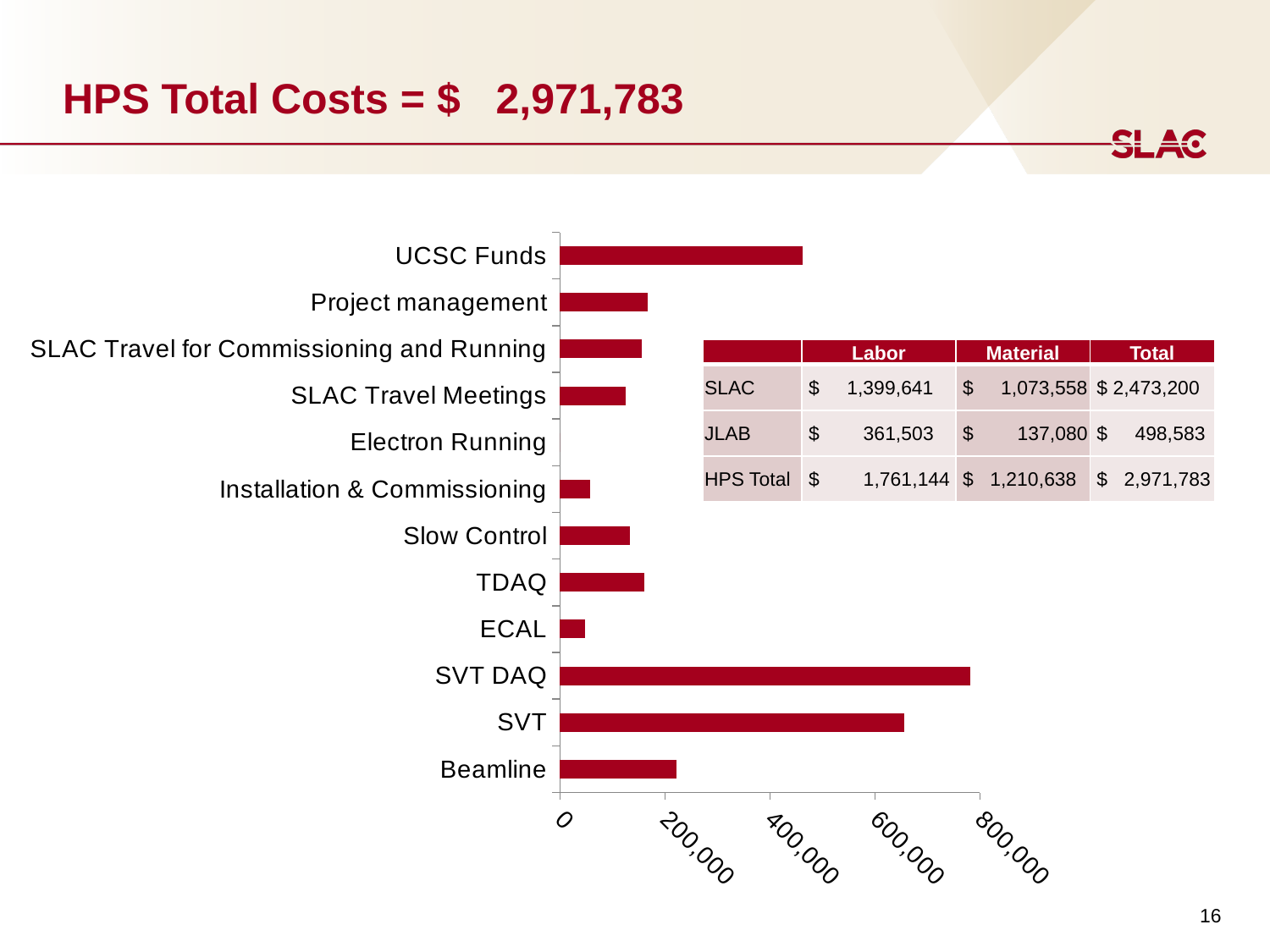
How many categories are plotted in the bar chart? 12 Is the value for UCSC Funds greater or less than 400,000? greater Is the value for ECAL greater or less than 200,000? less Is the value for Installation & Commissioning greater or less than 200,000? less Which is larger, the value for Project management or the value for ECAL? Project management What is the title of the slide containing the bar chart? HPS Total Costs = $ 2,971,783 Which category has the lowest value in the bar chart? Electron Running What kind of chart is shown on the slide? bar chart Which category has the highest value in the bar chart? SVT DAQ Which is larger, the value for SVT DAQ or the value for SVT? SVT DAQ Which is larger, the value for UCSC Funds or the value for Beamline? UCSC Funds